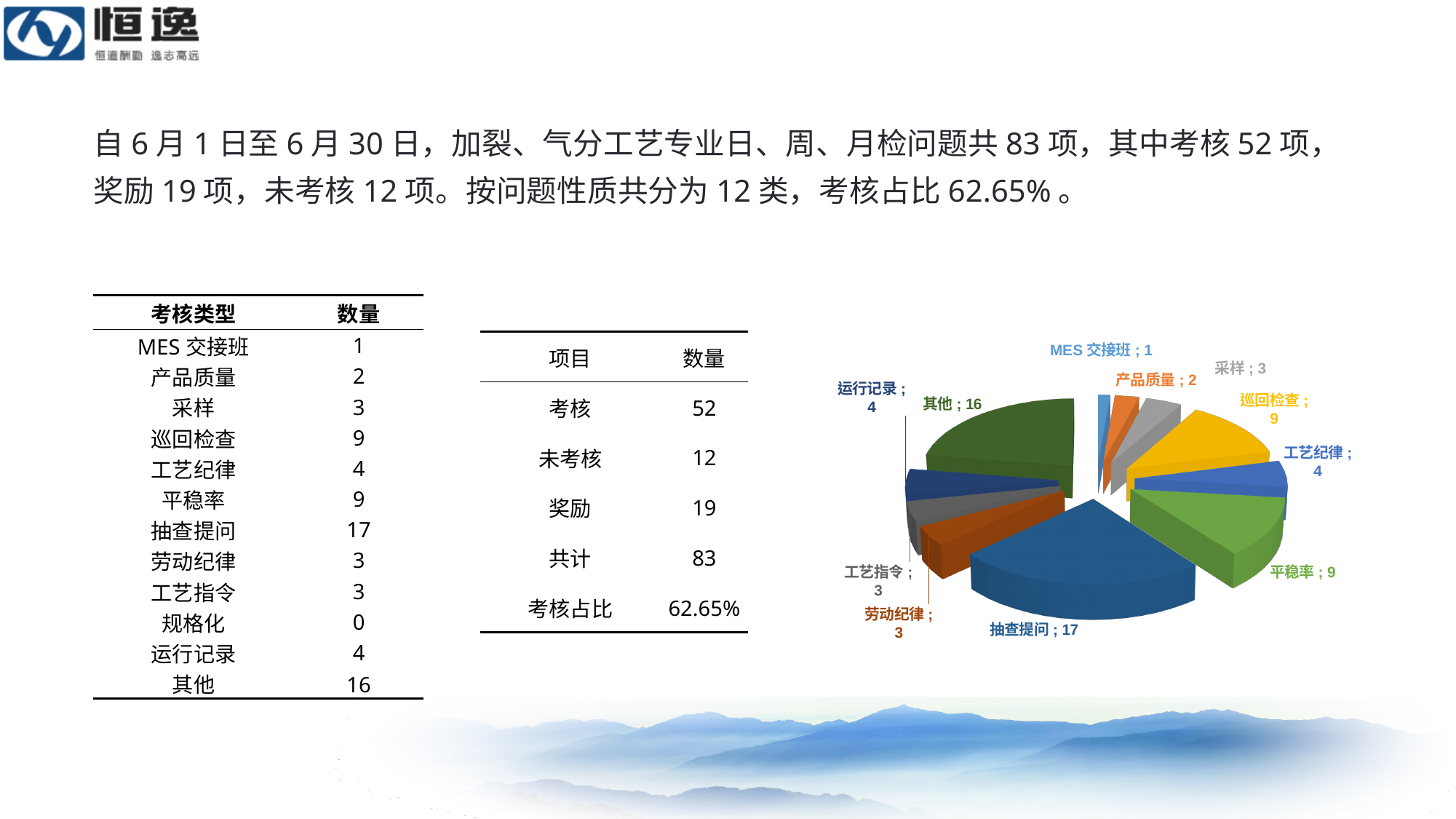
In the pie chart, what is the value for MES 交接班? 1 In the pie chart, what is the difference between the values for 抽查提问 and 其他? 1 How many slices are labelled in the pie chart? 11 In the pie chart, what colour is the 抽查提问 slice? blue Which slice of the pie chart has the largest value? 抽查提问 In the pie chart, what is the difference between the values for 平稳率 and 工艺纪律? 5 In the pie chart, which is larger, the value for 采样 or the value for 运行记录? 运行记录 In the pie chart, what is the value for 抽查提问? 17 In the pie chart, what is the value for 其他? 16 In the pie chart, what is the value for 巡回检查? 9 What kind of chart is shown on the slide? pie chart Which slice of the pie chart has the smallest value? MES 交接班